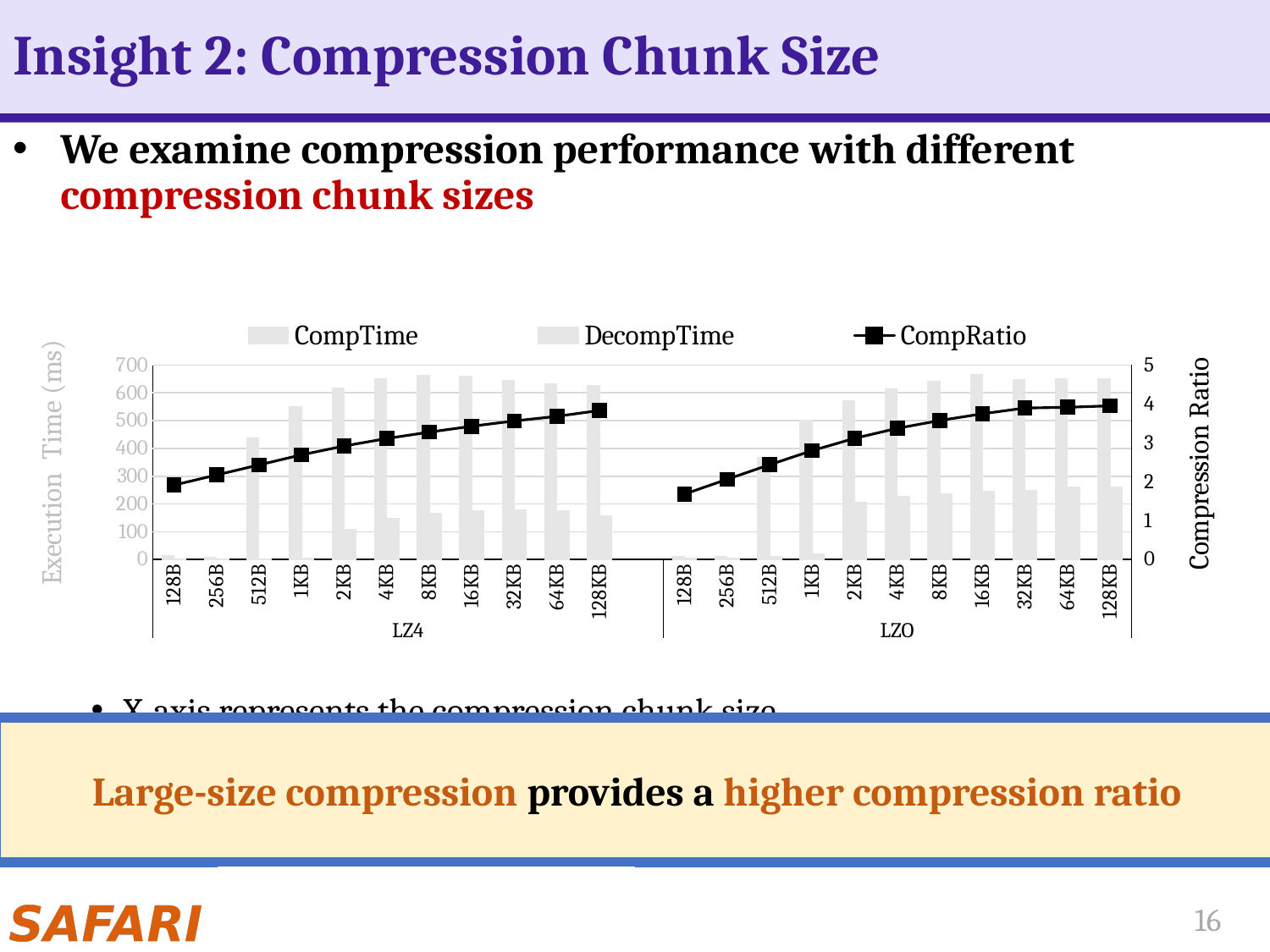
For LZO, which chunk size has the lowest CompRatio? 128B For LZ4 at 4KB, which is larger, CompTime or DecompTime? CompTime What are the three series named in the chart legend? CompTime, DecompTime, CompRatio Is the CompTime for LZ4 at 128KB greater or less than 500 ms? greater Does the CompRatio line rise or fall as the compression chunk size increases for LZO? Rises For LZ4, which chunk size has the highest CompRatio? 128KB What is the label of the right-hand vertical axis of the chart? Compression Ratio What kind of chart is shown on the slide? Combined bar and line chart How many compression chunk sizes are shown on the x axis for the LZ4 group? 11 Is the CompRatio for LZ4 at 128KB greater or less than 3? greater How many series does the chart legend list? 3 Is the CompRatio for LZO at 128B greater or less than 2? less